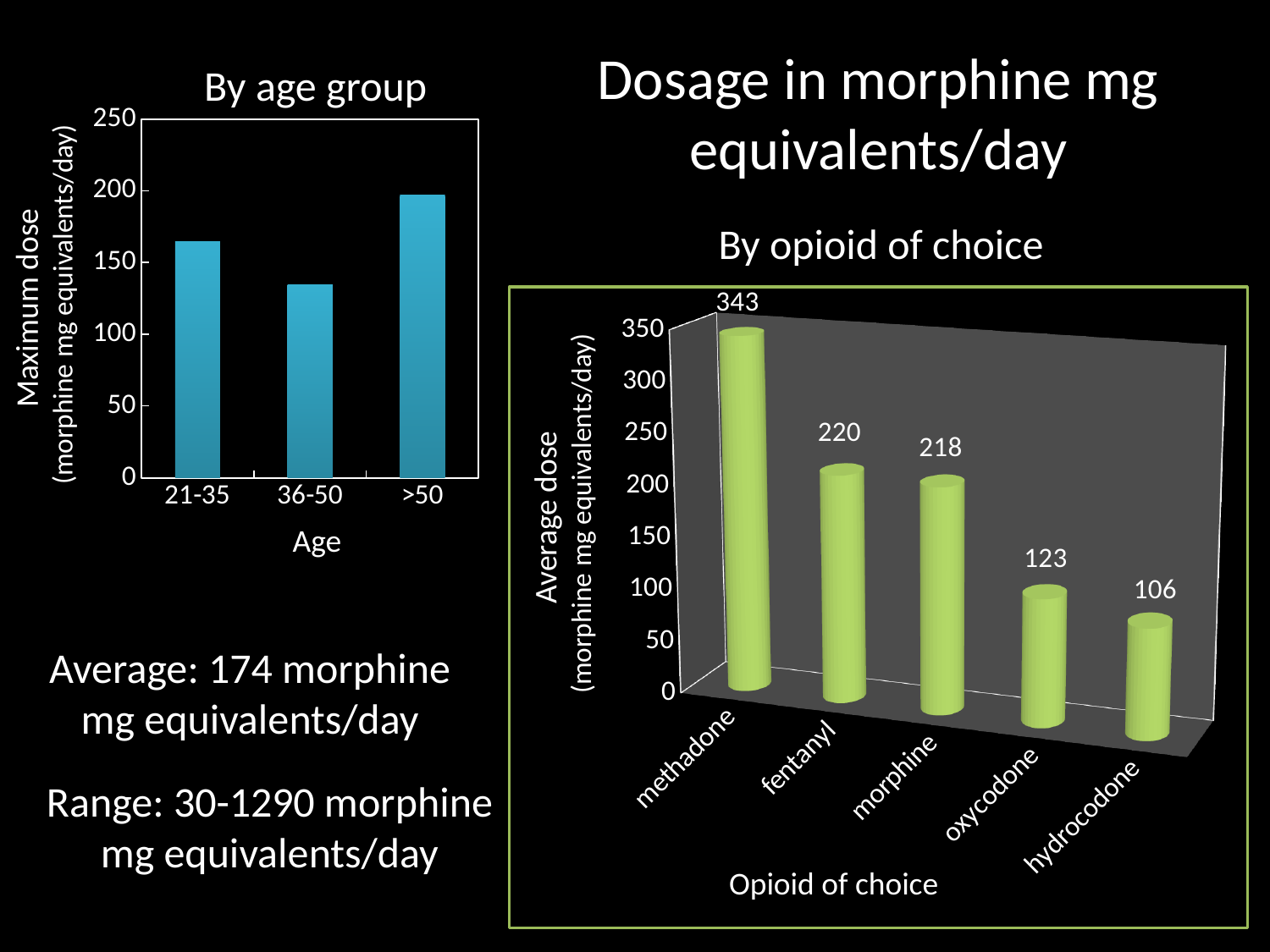
In the 'By opioid of choice' chart, what is the average dose for methadone? 343 In the 'By opioid of choice' chart, which has the larger average dose, fentanyl or morphine? fentanyl In the 'By age group' chart, which age group has the lowest maximum dose? 36-50 In the 'By opioid of choice' chart, what is the average dose for oxycodone? 123 What kind of chart is the 'By opioid of choice' chart? bar chart In the 'By age group' chart, is the value for the 21-35 age group greater or less than 150? greater How many opioids are shown in the 'By opioid of choice' chart? 5 In the 'By opioid of choice' chart, which opioid has the highest average dose? methadone In the 'By opioid of choice' chart, what is the difference between the average dose for methadone and for fentanyl? 123 In the 'By opioid of choice' chart, which opioid has the lowest average dose? hydrocodone In the 'By age group' chart, which age group has the highest maximum dose? >50 In the 'By age group' chart, is the value for the 36-50 age group greater or less than 150? less